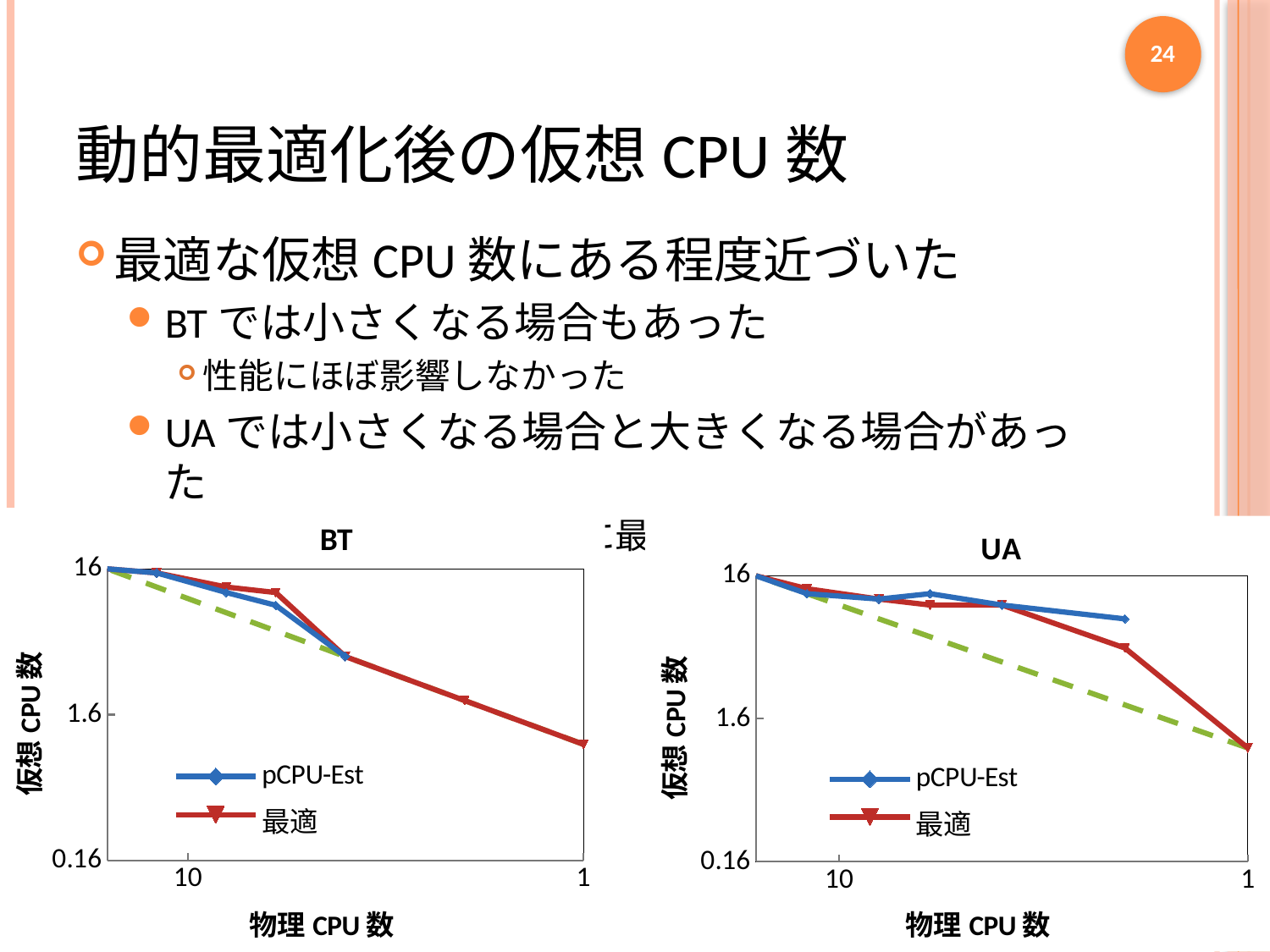
In the BT chart, do the values of the 最適 series rise or fall as the physical CPU count goes from 10 toward 1 along the x axis? fall In the BT chart, is the value of the 最適 series at a physical CPU count of 1 greater or less than 1.6? less What kind of chart is the BT chart on the left? line chart How many series does the legend of the UA chart list? 2 In the UA chart, do the values of the pCPU-Est series rise or fall overall as the physical CPU count decreases along the x axis? fall In the UA chart, is the value of the 最適 series at a physical CPU count of 1 greater or less than 0.16? greater In the UA chart, is the value of the pCPU-Est series at its rightmost point (around a physical CPU count of 2) greater or less than 1.6? greater What are the two series named in the legend of the BT chart? pCPU-Est and 最適 In the UA chart, at the rightmost point of the pCPU-Est series (around a physical CPU count of 2), which series has the larger value, pCPU-Est or 最適? pCPU-Est In the BT chart, which series reaches the lowest value on the chart? 最適 What is the x-axis label of the UA chart? 物理 CPU 数